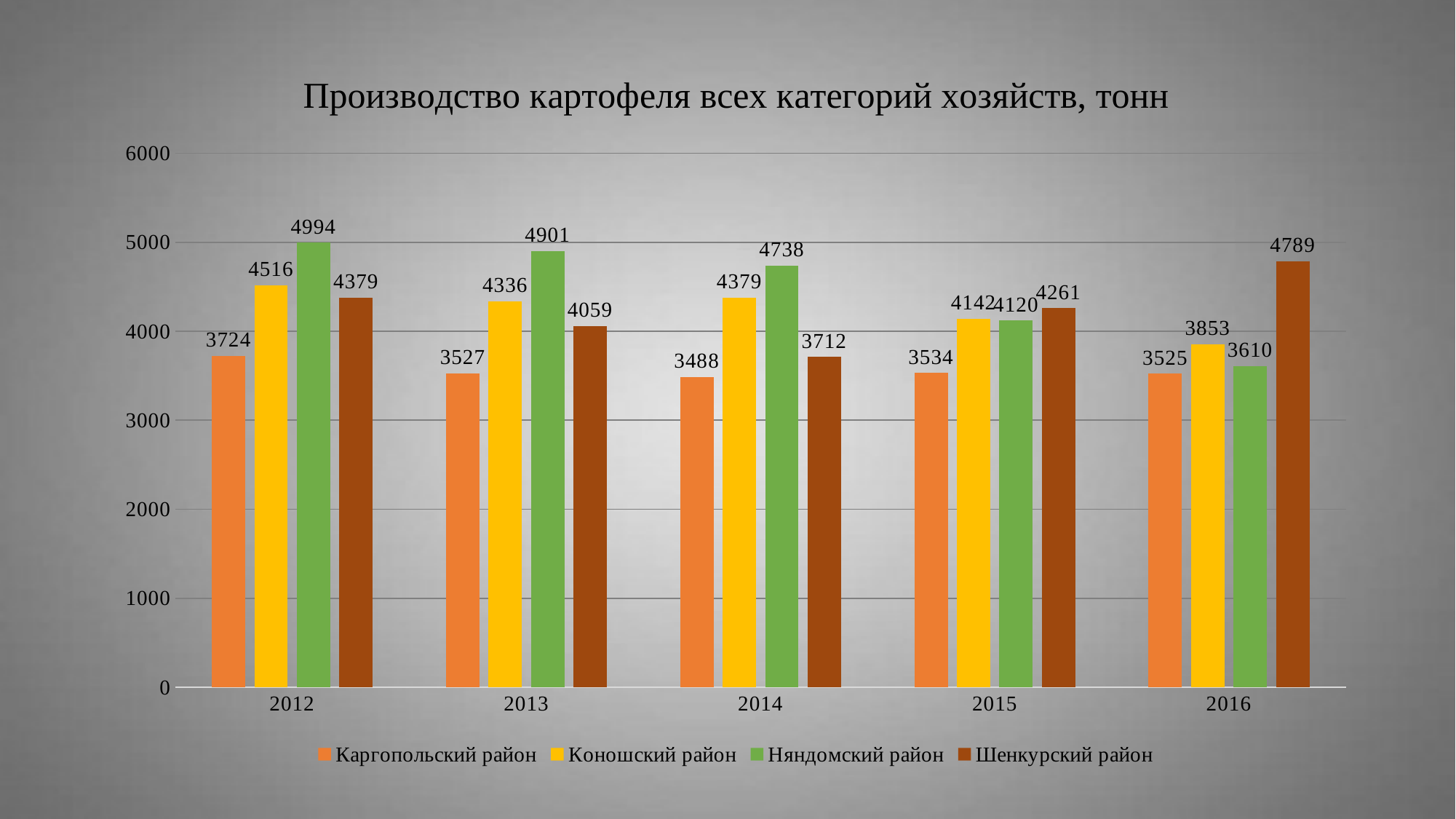
Which is larger in 2015: Коношский район or Шенкурский район? Шенкурский район What is the value for Каргопольский район in 2014? 3488 How many years are shown on the x axis? 5 Which district has the highest value in 2013? Няндомский район What is the difference between Няндомский район and Каргопольский район in 2012? 1270 What is the value for Няндомский район in 2012? 4994 What kind of chart is shown on the slide? bar chart Is the value for Шенкурский район in 2014 greater or less than 4000? less Which district has the lowest value in 2016? Каргопольский район What is the value for Шенкурский район in 2016? 4789 Do the values for Няндомский район rise or fall from 2012 to 2016? fall How many series does the legend list? 4